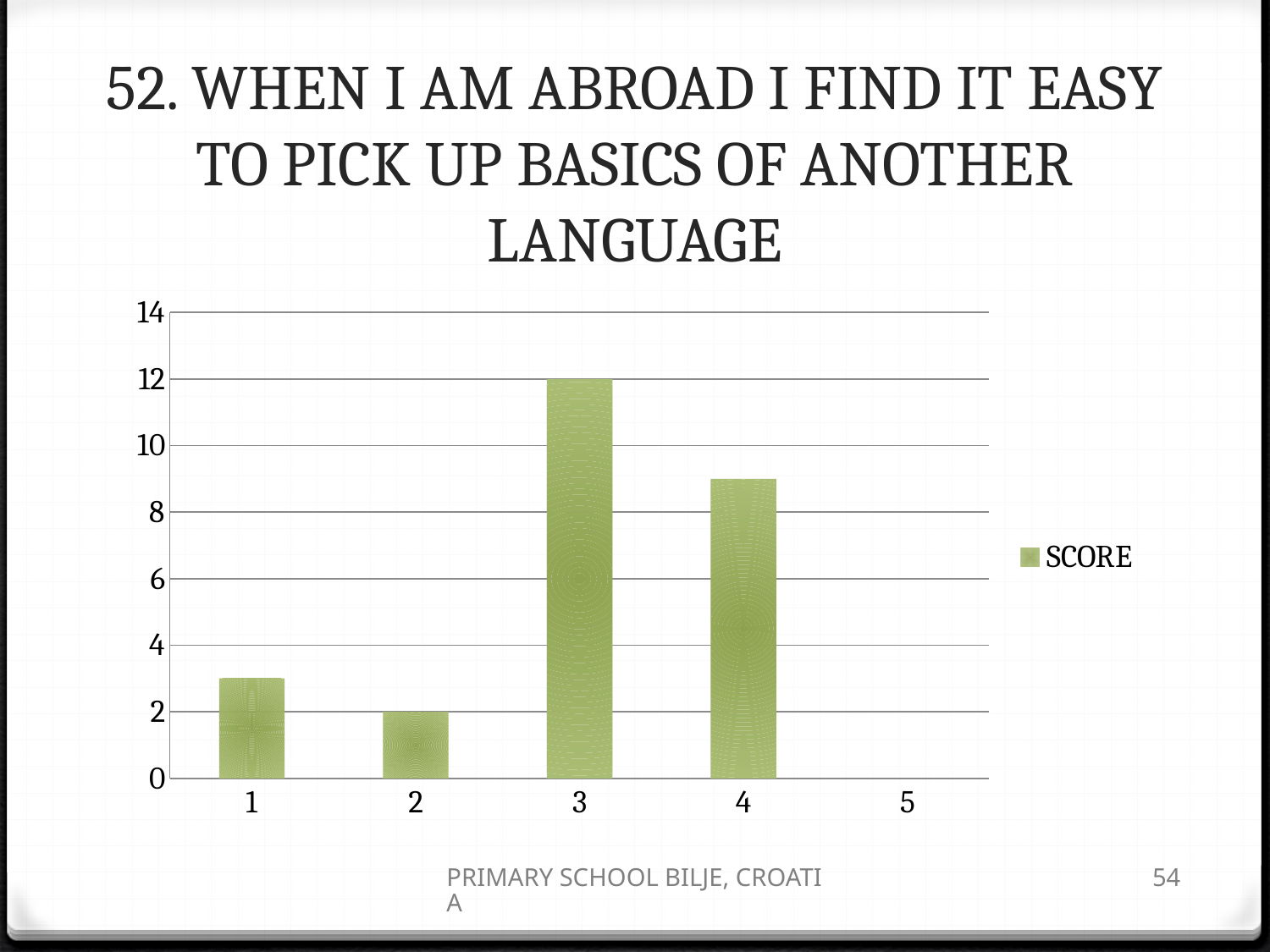
Is the SCORE value for category 4 greater or less than 8? greater What kind of chart is shown on the slide? bar chart How many categories are shown on the x axis? 5 Which category has the highest SCORE? 3 What is the SCORE value for category 2? 2 Is the SCORE value for category 1 greater or less than 4? less How many series does the legend list? 1 Which has a larger SCORE, category 3 or category 4? 3 Which category has the lowest SCORE? 5 What is the SCORE value for category 3? 12 What is the SCORE value for category 5? 0 What is the difference between the SCORE values for category 3 and category 2? 10